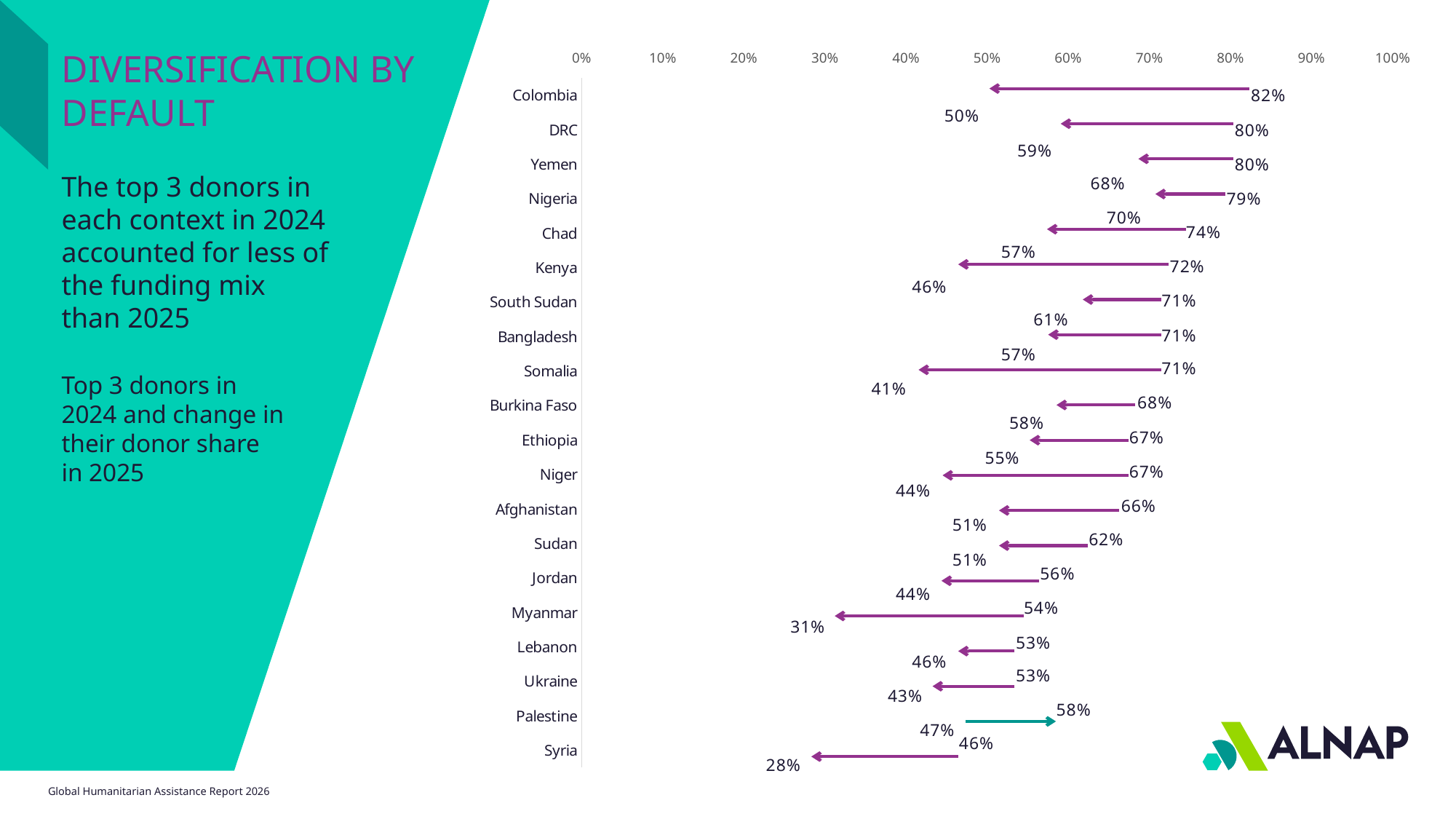
By how many percentage points does the Palestine arrow rise from its start to its end? 11 percentage points What is the value at the head of the arrow for Palestine? 58% How many countries are listed on the chart? 20 At what value does the arrow for Syria end (its head)? 28% Which country has the lowest arrow end value? Syria What is the difference between the start and end values of the arrow for Somalia? 30 percentage points Which country is the only one whose arrow points to the right (an increase) and is drawn in green? Palestine At what value does the arrow for Colombia start (its tail)? 82% What range does the horizontal axis cover? 0% to 100% Which is larger: the arrow end value for Myanmar or for Syria? Myanmar Which country has the highest arrow starting value? Colombia What is the difference between the start and end values of the arrow for Colombia? 32 percentage points